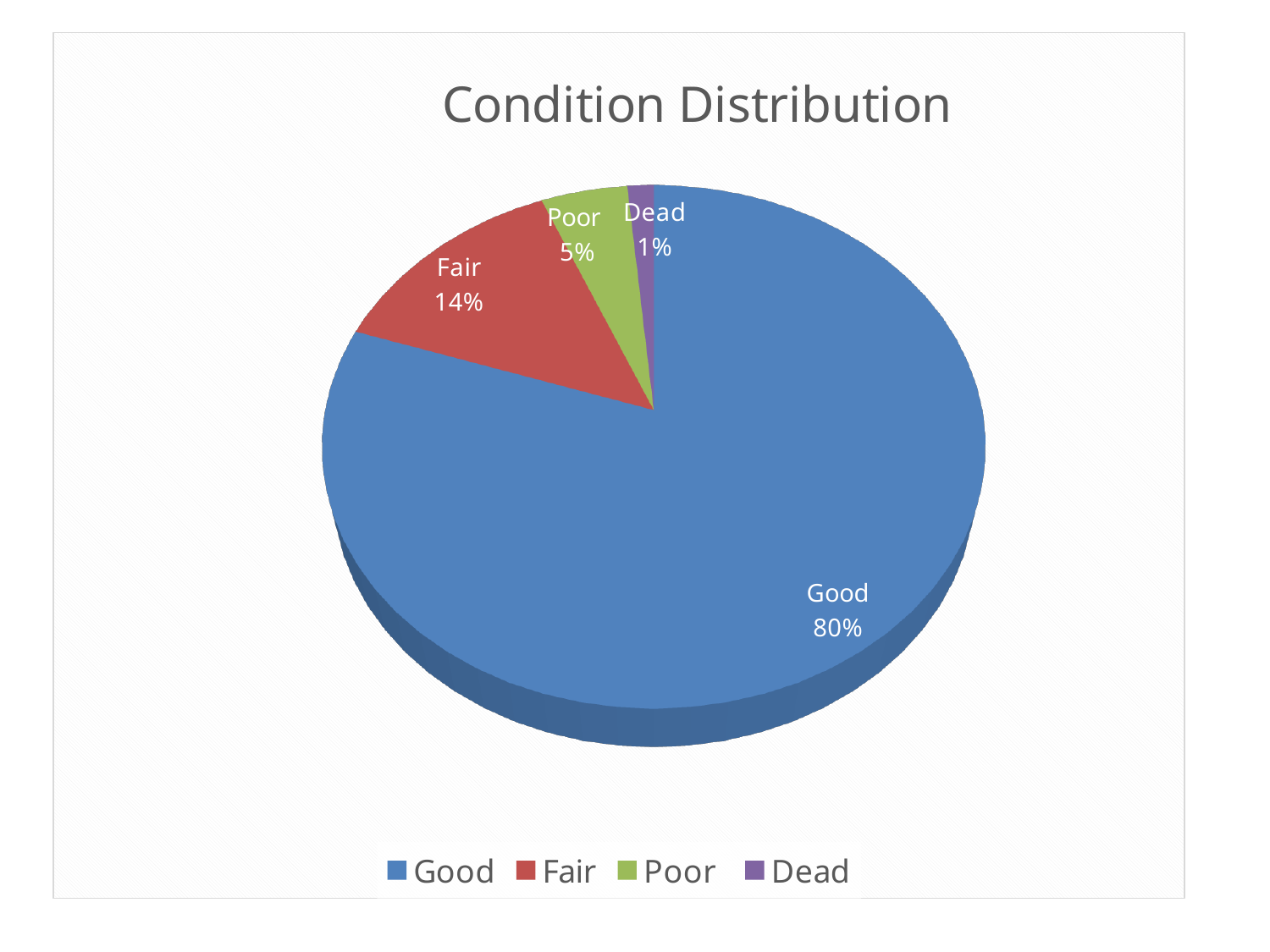
What is the difference in percentage points between the Fair and Poor slices? 9 What share of the pie does the Dead slice represent? 1% What share of the pie does the Poor slice represent? 5% What colour is the Fair slice in the pie chart? red Which category has the smallest slice of the pie? Dead What share of the pie does the Good slice represent? 80% What kind of chart is shown on the slide? pie chart Which slice is larger, Poor or Dead? Poor How many categories are shown in the pie chart? 4 Which category has the largest slice of the pie? Good What is the title of the chart? Condition Distribution